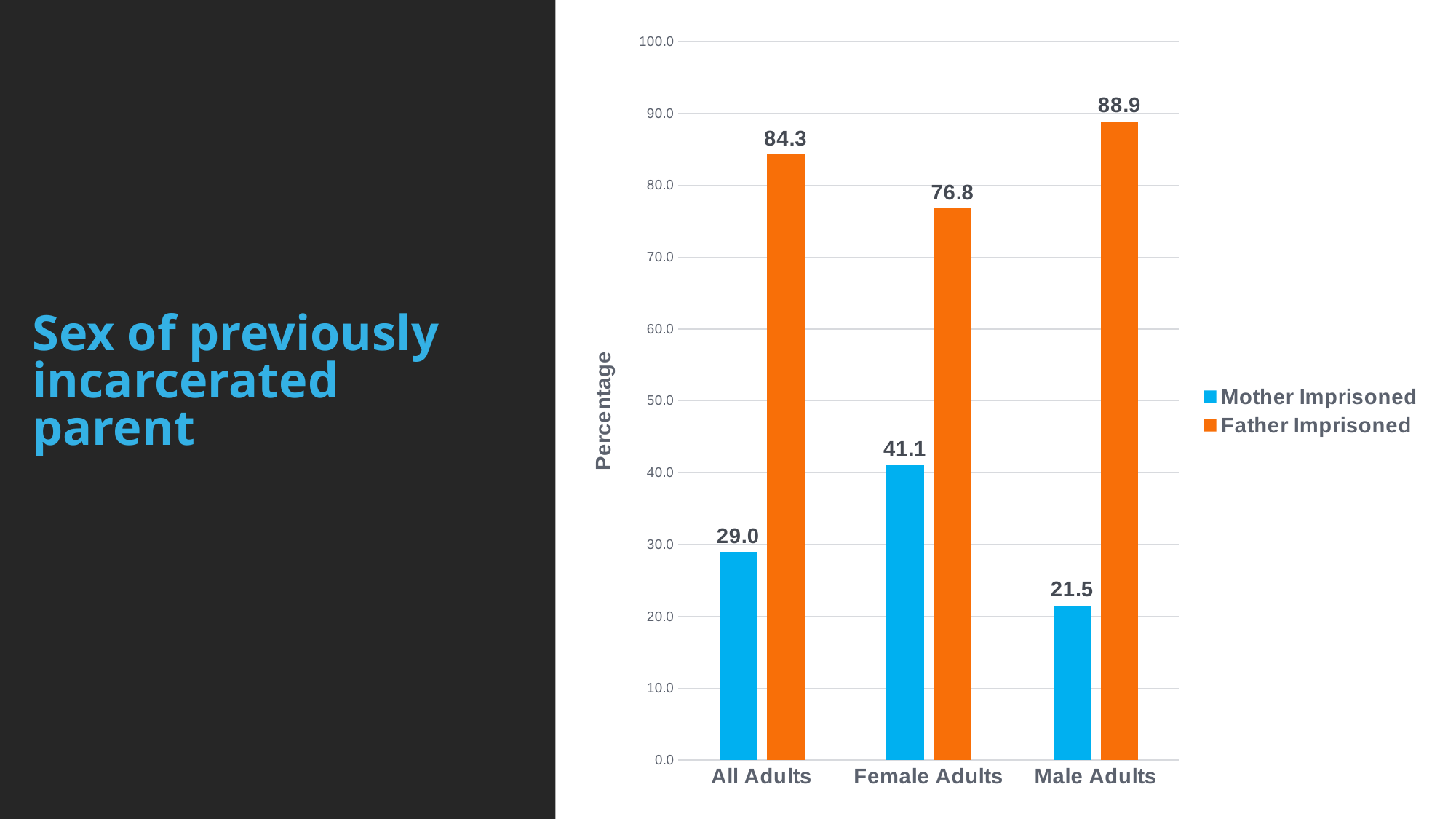
Is the Father Imprisoned value for Female Adults greater or less than 80.0? less Which category has the lowest Mother Imprisoned value? Male Adults What is the value for Father Imprisoned among Male Adults? 88.9 What is the value for Mother Imprisoned among Female Adults? 41.1 What is the difference between the Father Imprisoned and Mother Imprisoned values for All Adults? 55.3 How many series does the legend list? 2 What is the difference between the Father Imprisoned values for Male Adults and Female Adults? 12.1 How many categories are shown on the x axis? 3 What kind of chart is shown on the slide? Bar chart What is the value for Mother Imprisoned among All Adults? 29.0 Which category has the highest Father Imprisoned value? Male Adults Which is larger: the Mother Imprisoned value for Female Adults or for Male Adults? Female Adults